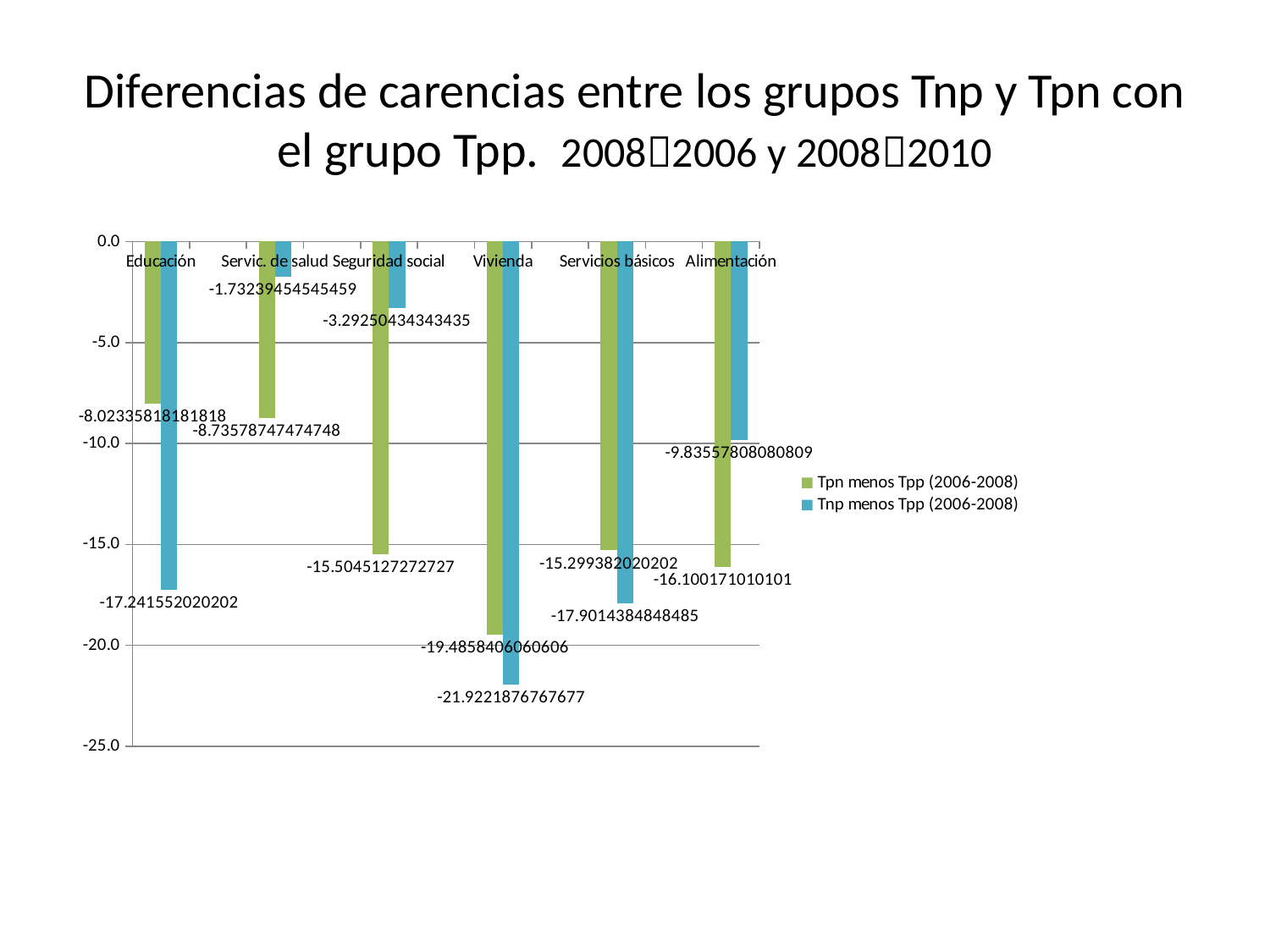
How many categories are shown on the x axis? 6 Which category has the highest (least negative) value in the Tpn menos Tpp (2006-2008) series? Educación Which is larger for Seguridad social: the Tpn menos Tpp (2006-2008) value or the Tnp menos Tpp (2006-2008) value? Tnp menos Tpp (2006-2008) Which colour represents the Tnp menos Tpp (2006-2008) series? blue Which category has the lowest value in the Tnp menos Tpp (2006-2008) series? Vivienda What is the value for Alimentación in the Tpn menos Tpp (2006-2008) series? -16.100171010101 Is the value for Servicios básicos in the Tnp menos Tpp (2006-2008) series greater or less than -15.0? less What is the value for Vivienda in the Tpn menos Tpp (2006-2008) series? -19.4858406060606 What kind of chart is shown on the slide? bar chart How many series does the legend list? 2 What is the value for Servic. de salud in the Tnp menos Tpp (2006-2008) series? -1.73239454545459 What is the value for Educación in the Tnp menos Tpp (2006-2008) series? -17.241552020202